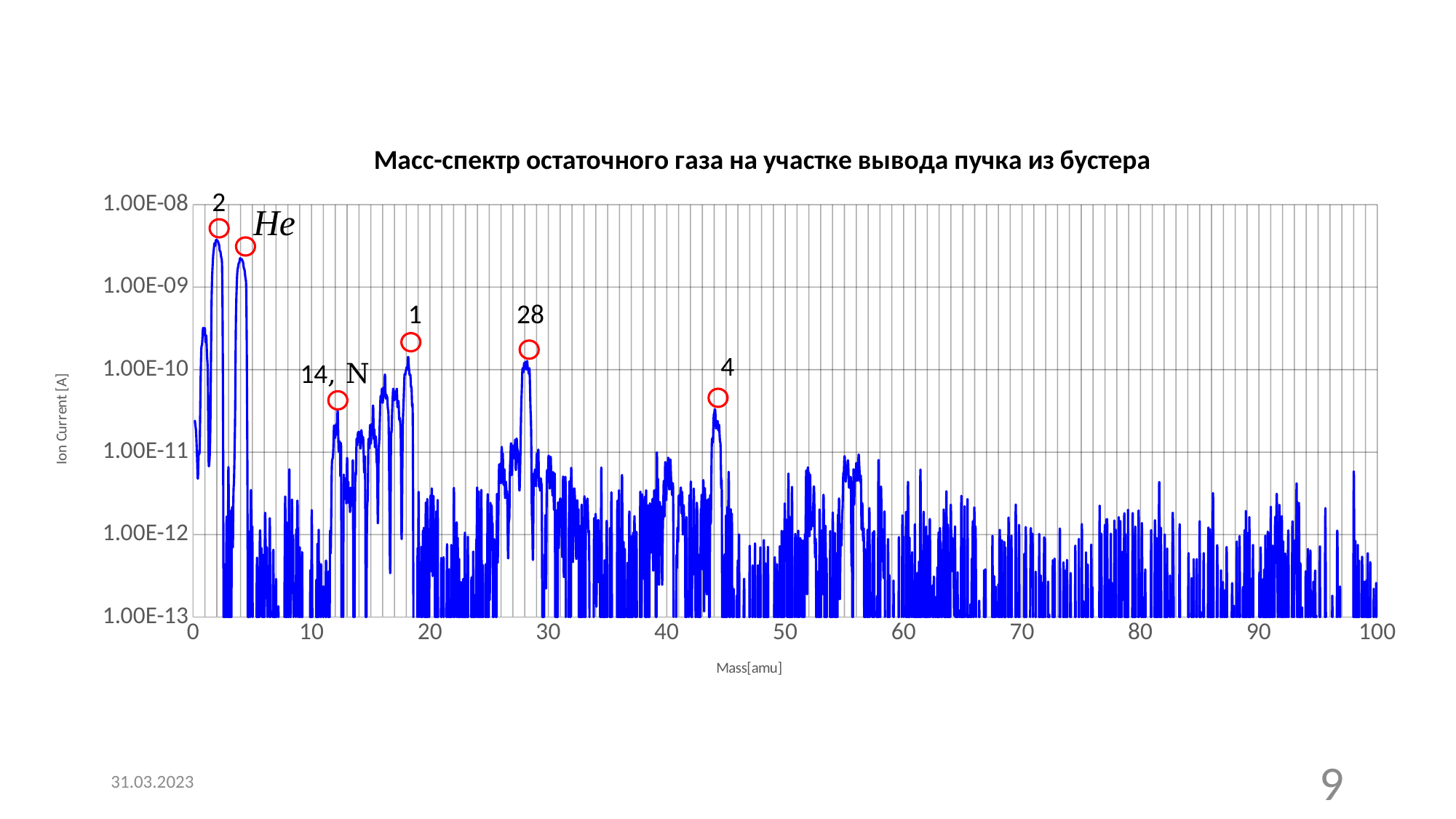
Is the peak ion current near mass 44 (labelled '4') greater or less than 1.00E-10? less Which peak is higher: the one near mass 2 or the one near mass 28? the one near mass 2 What is the highest value shown on the y axis of the chart? 1.00E-08 What is the title of the chart? Масс-спектр остаточного газа на участке вывода пучка из бустера Is the peak ion current at the point labelled 'He' greater or less than 1.00E-09? greater Is the peak ion current near mass 28 greater or less than 1.00E-11? greater What kind of chart is shown on the slide? line chart What is the label of the x axis of the chart? Mass[amu] What is the lowest value shown on the y axis of the chart? 1.00E-13 Near which mass value does the highest peak of the spectrum occur? 2 What is the maximum mass value shown on the x axis of the chart? 100